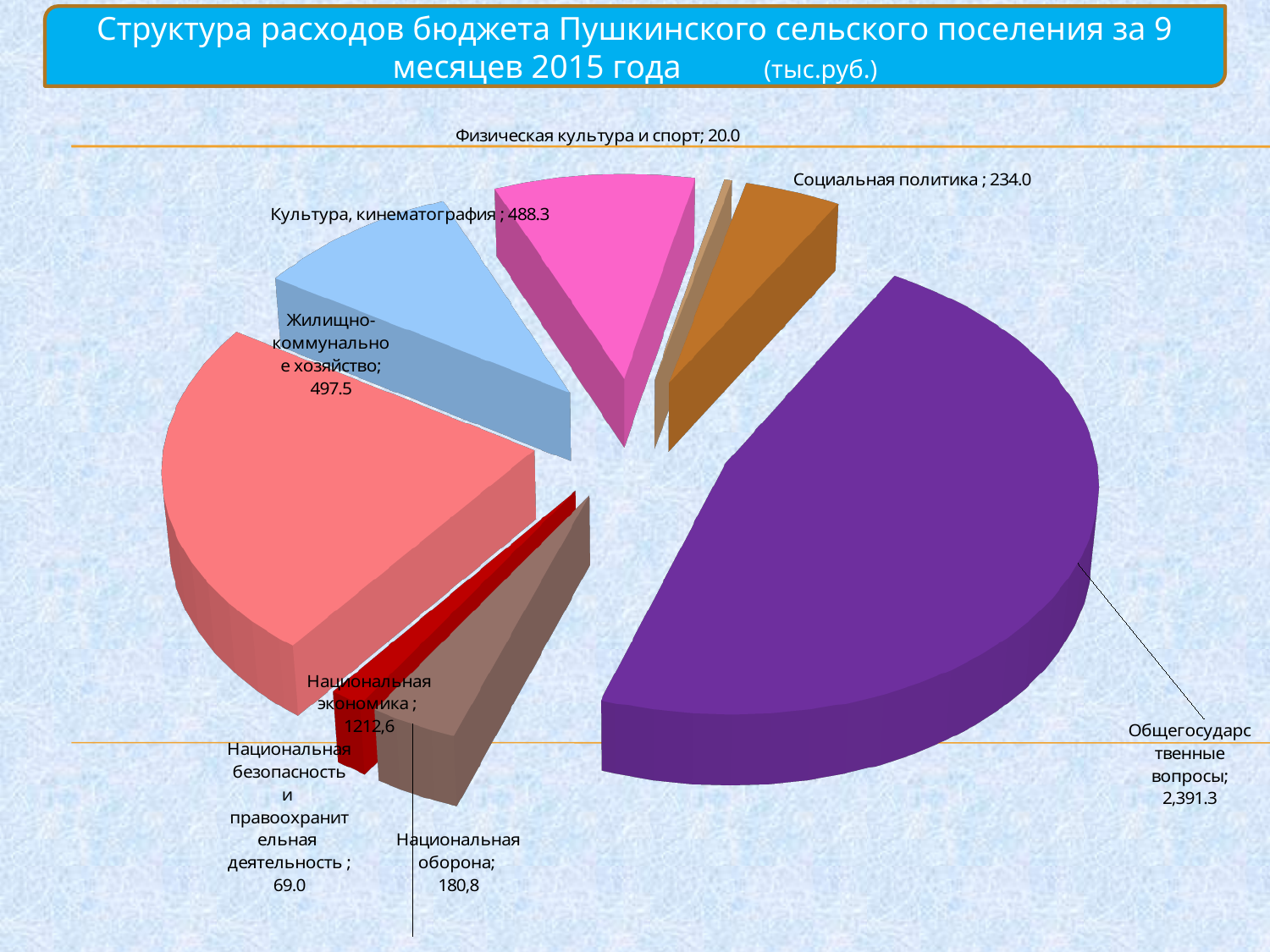
Which category has the largest value? Общегосударственные вопросы What colour is the slice for Общегосударственные вопросы? Purple How many categories (slices) does the pie chart have? 8 Which category has the smallest value? Физическая культура и спорт What is the difference between Социальная политика and Национальная оборона? 53.2 What is the value for Национальная оборона? 180,8 What is the value for Жилищно-коммунальное хозяйство? 497.5 What is the value for Общегосударственные вопросы? 2,391.3 What unit of measurement is stated in the chart title? тыс.руб. What kind of chart is shown on the slide? Pie chart Which is larger: Социальная политика or Национальная безопасность и правоохранительная деятельность? Социальная политика What is the value for Национальная экономика? 1212,6